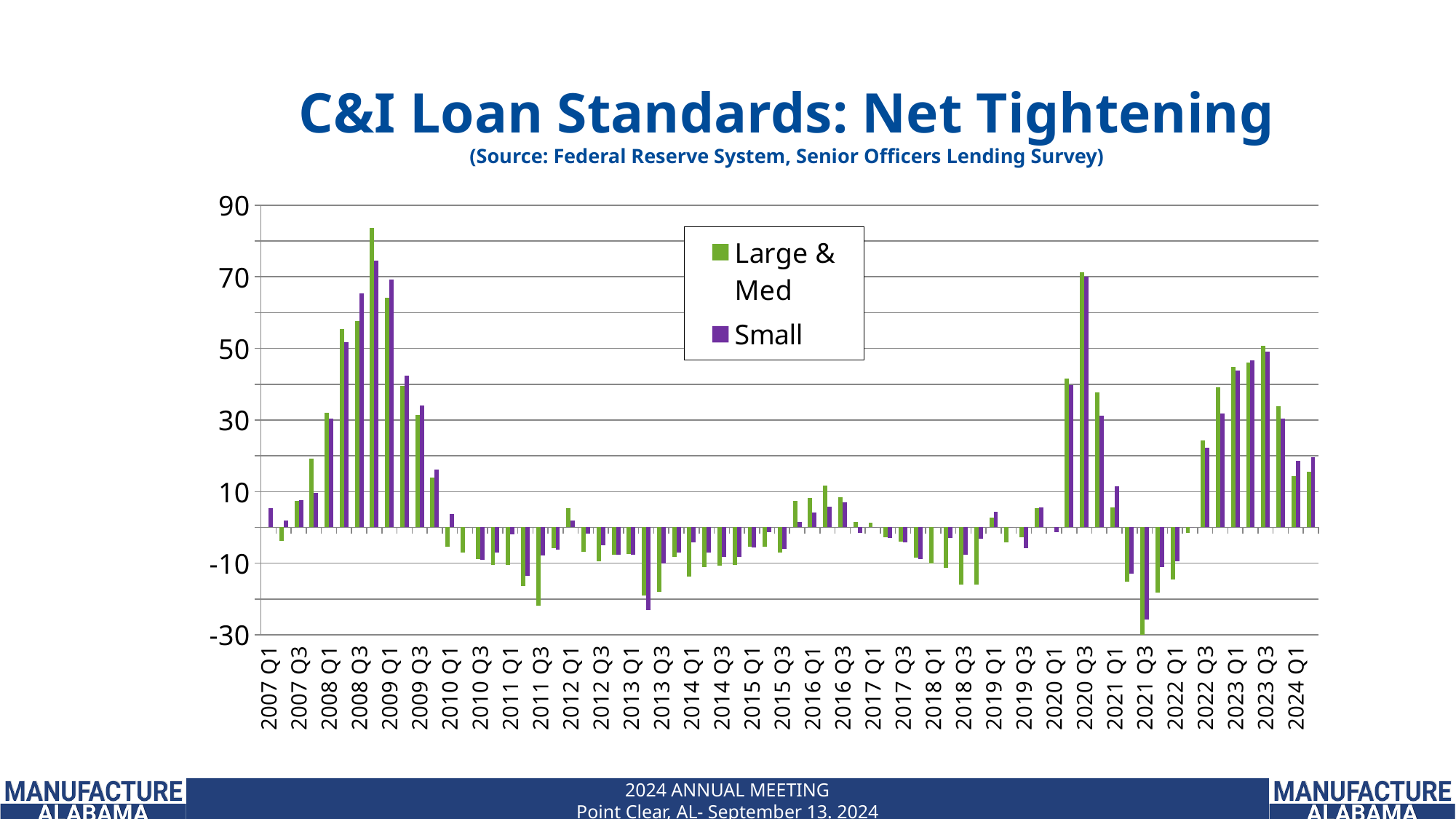
Is the Small value for 2020 Q3 greater or less than 50? greater At 2008 Q3, which series has the larger value, Large & Med or Small? Small Is the Small value for 2024 Q1 greater or less than 10? greater Is the Large & Med value for 2021 Q3 greater or less than -10? less What kind of chart is shown on the slide? bar chart Which quarter has the lowest Large & Med value? 2021 Q3 How many series does the legend list? 2 Between 2009 Q1 and 2010 Q1, do the Large & Med values generally rise or fall? fall What are the two series named in the legend? Large & Med; Small What is the title of the chart? C&I Loan Standards: Net Tightening